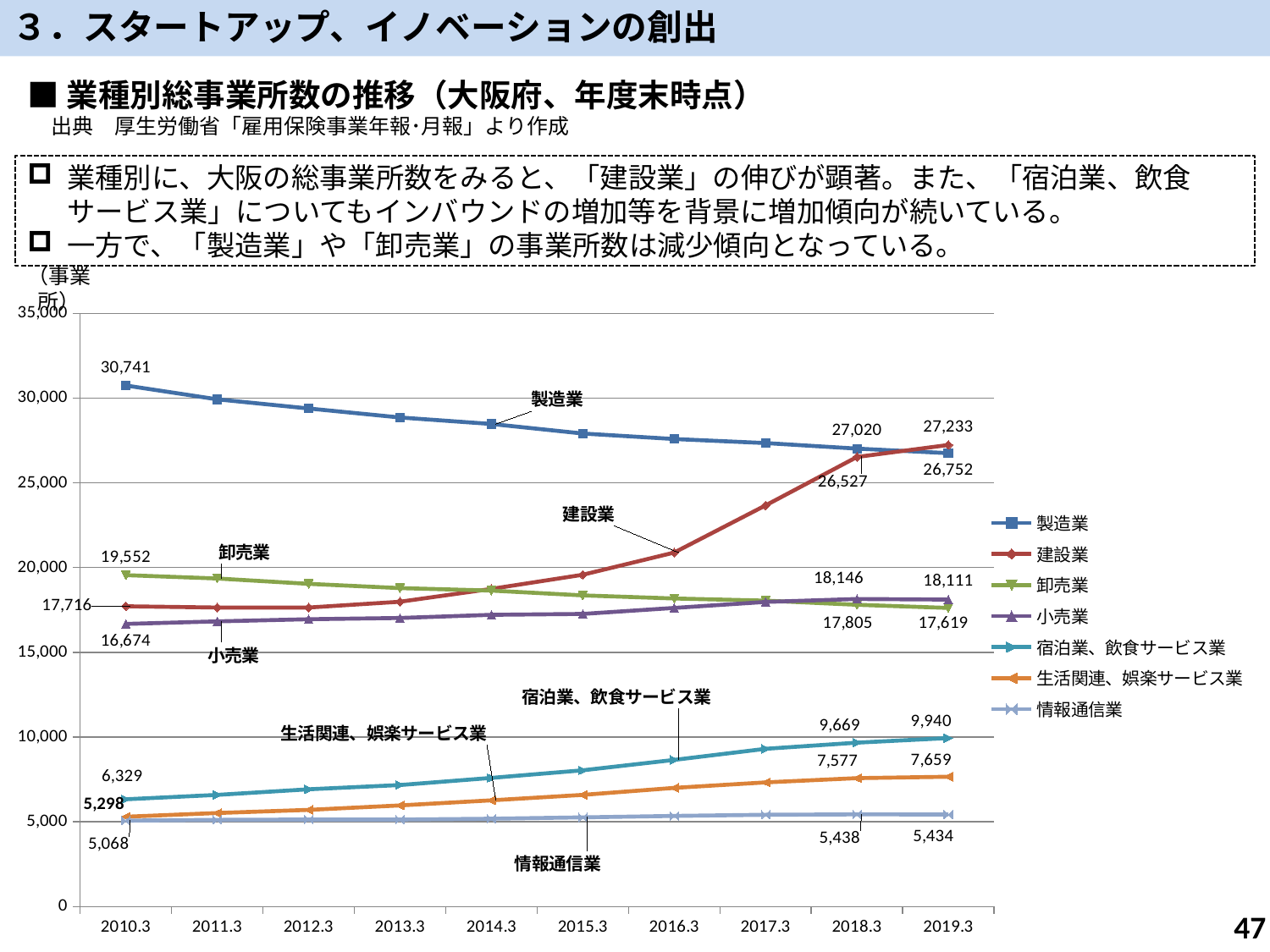
Is the value for 建設業 at 2016.3 greater or less than 20,000? greater What is the value for 製造業 at 2010.3? 30,741 Which series has the lowest value at 2010.3? 情報通信業 How many series does the legend list? 7 How many time points are shown on the x axis? 10 At 2019.3, which is larger: 卸売業 or 小売業? 小売業 Does the value for 製造業 rise or fall from 2010.3 to 2019.3? fall What is the value for 建設業 at 2019.3? 27,233 What type of chart is shown on the slide? line chart What is the value for 宿泊業、飲食サービス業 at 2018.3? 9,669 Which series has the highest value at 2019.3? 建設業 What is the difference between the 建設業 values at 2019.3 and 2010.3? 9,517